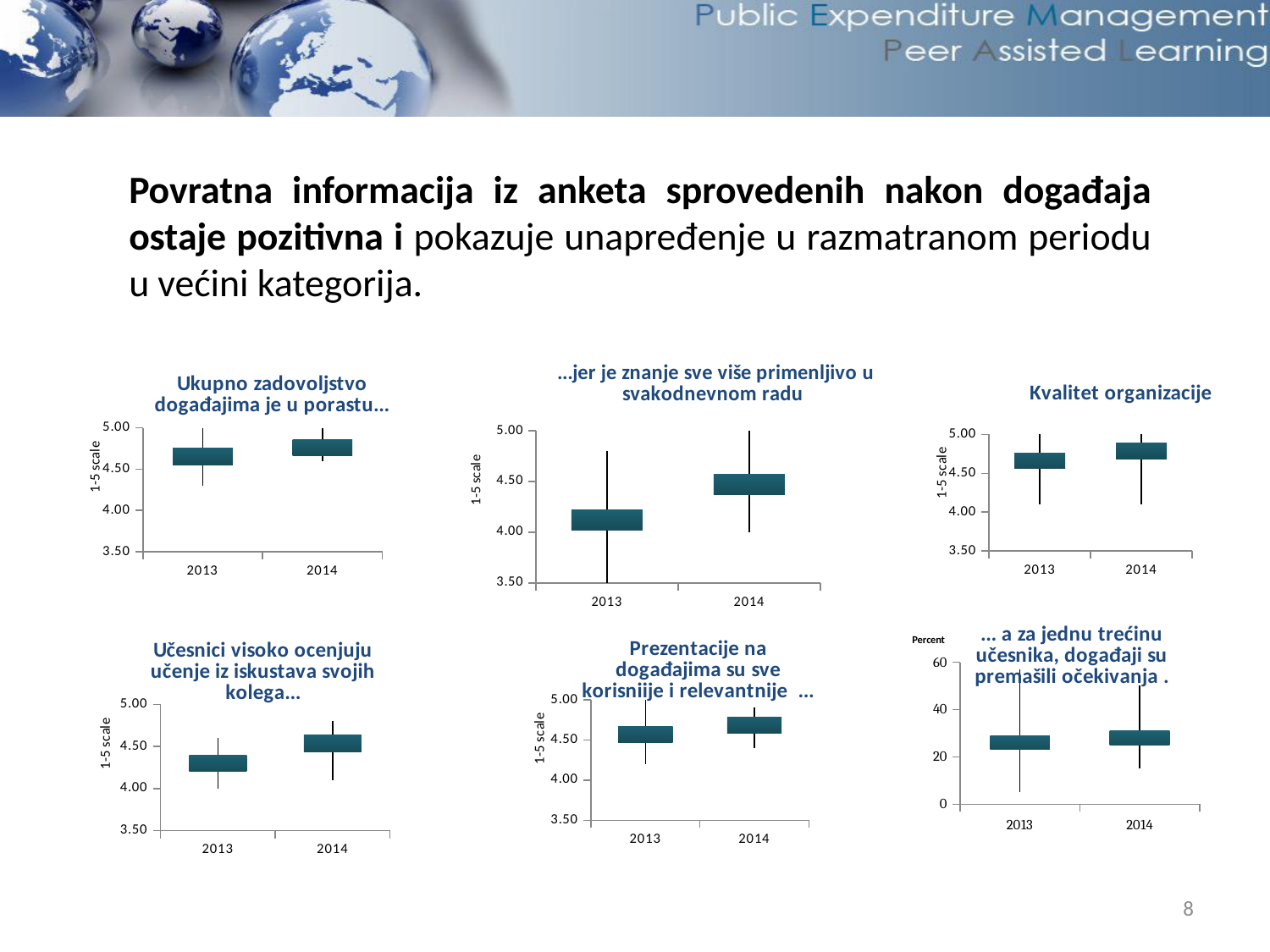
In the chart titled "Kvalitet organizacije", is the value for 2014 greater or less than 4.00? greater In the chart titled "Ukupno zadovoljstvo događajima je u porastu...", do the values rise or fall from 2013 to 2014? rise In the chart titled "...jer je znanje sve više primenljivo u svakodnevnom radu", is the value for 2014 greater or less than 4.00? greater What is the y-axis label of the bottom-right chart on the slide? Percent In the chart titled "Učesnici visoko ocenjuju učenje iz iskustava svojih kolega...", which year has the higher value, 2013 or 2014? 2014 In the chart titled "Prezentacije na događajima su sve korisnije i relevantnije ...", is the value for 2013 greater or less than 4.00? greater In the chart titled "...jer je znanje sve više primenljivo u svakodnevnom radu", which year has the higher value, 2013 or 2014? 2014 How many categories are shown on the x axis of the chart titled "Ukupno zadovoljstvo događajima je u porastu..."? 2 What is the y-axis label of the chart titled "Kvalitet organizacije"? 1-5 scale